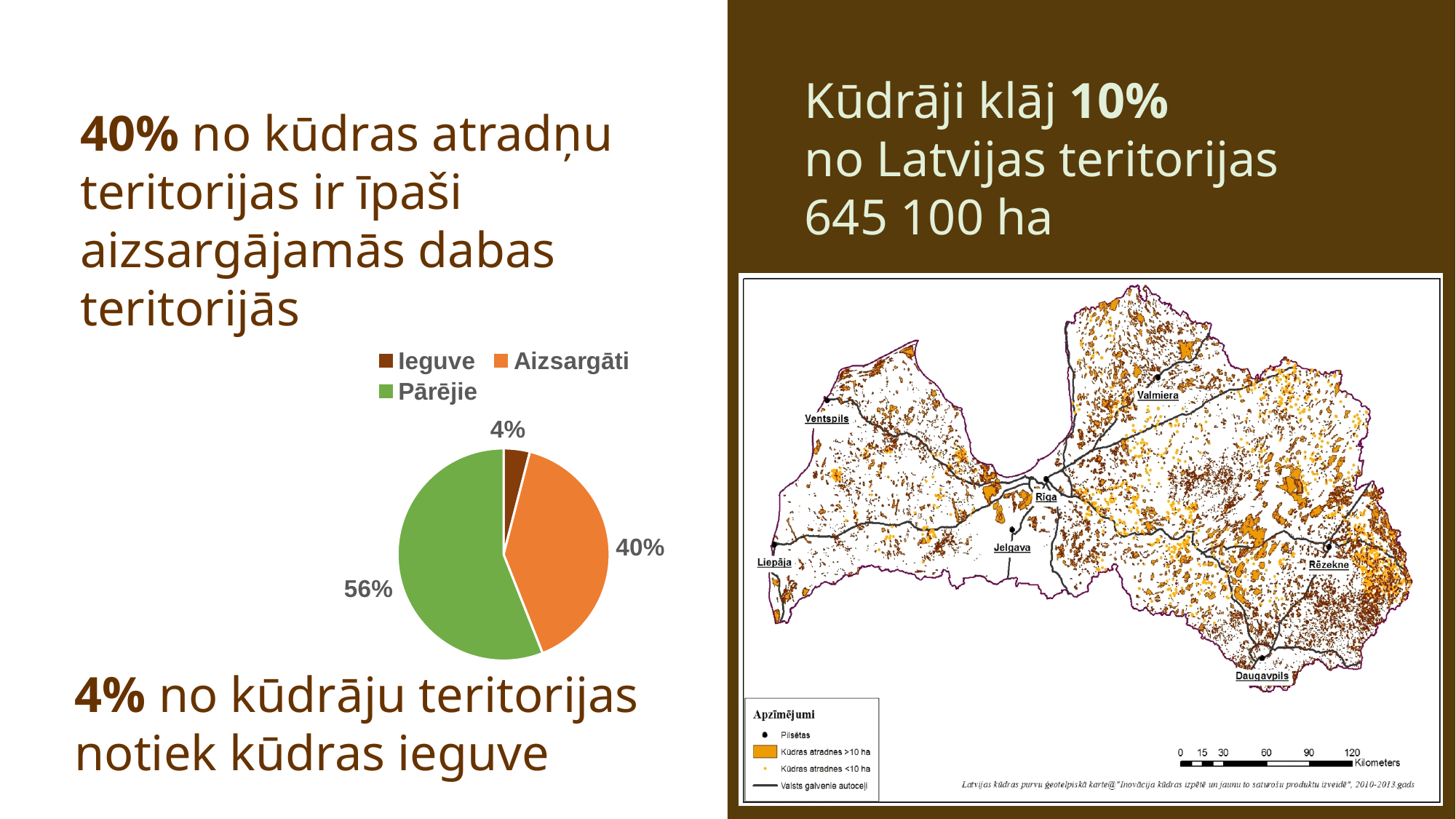
Which slice is larger, Aizsargāti or Ieguve? Aizsargāti What share of the pie does the Ieguve slice represent? 4% What is the difference in percentage points between the Pārējie and Aizsargāti slices? 16 How many entries does the legend of the pie chart list? 3 What colour is the Pārējie slice in the pie chart? green Which category has the smallest slice of the pie? Ieguve Which category has the largest slice of the pie? Pārējie What share of the pie does the Pārējie slice represent? 56% What share of the pie does the Aizsargāti slice represent? 40% What kind of chart is shown on the slide? pie chart How many slices does the pie chart have? 3 What colour is the Aizsargāti slice in the pie chart? orange